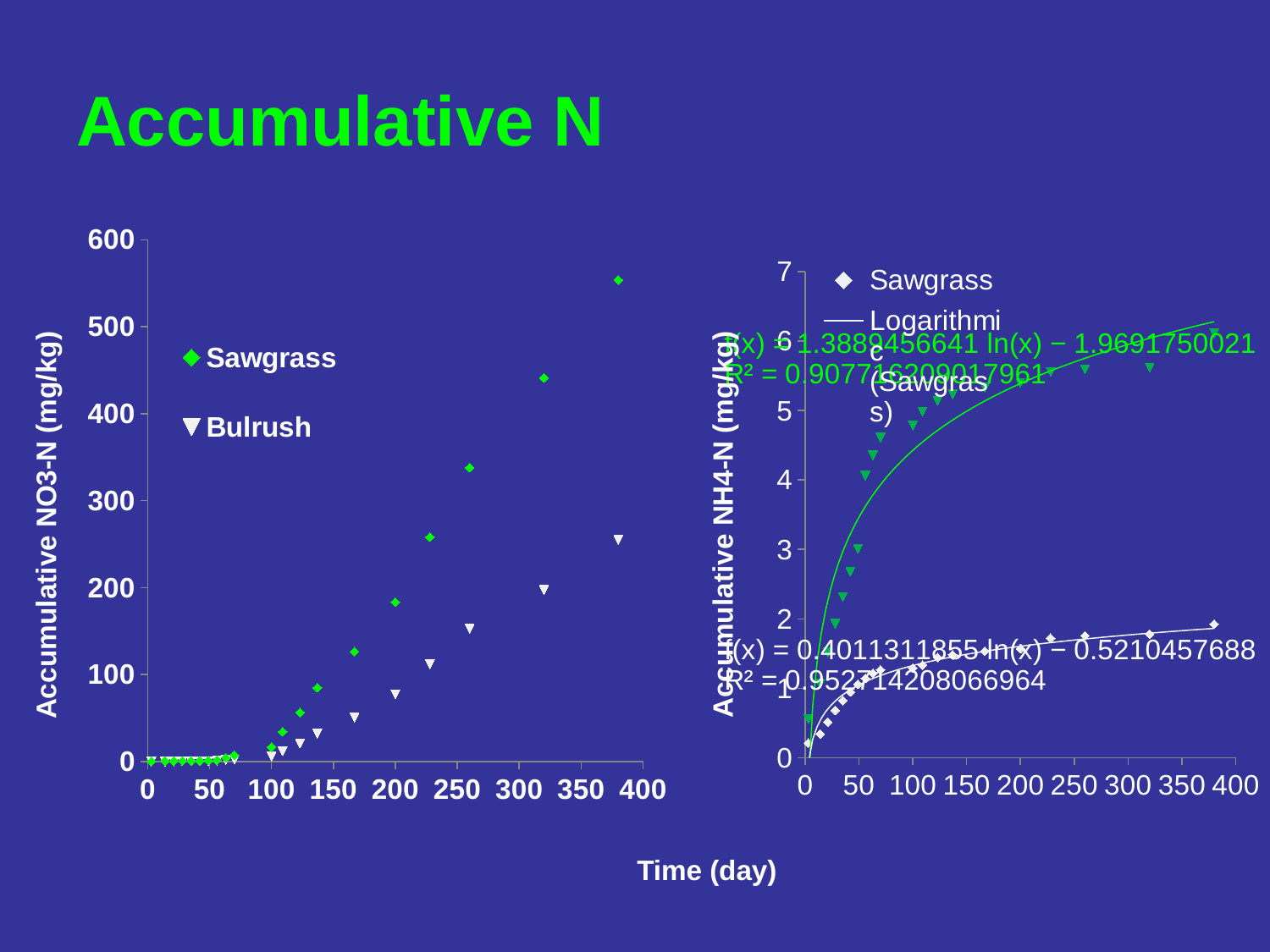
In the left chart (Accumulative NO3-N), how many series does the legend list? 2 What kind of chart is the left chart, titled with the y-axis 'Accumulative NO3-N (mg/kg)'? Scatter chart In the right chart (Accumulative NH4-N), is the green triangle series value at the last time point (around 380 days) greater or less than 5? greater In the left chart (Accumulative NO3-N), is the Bulrush value at the last time point (around 380 days) greater or less than 300? less In the left chart (Accumulative NO3-N), do the Sawgrass values rise or fall as time increases? Rise In the left chart (Accumulative NO3-N), which series has the higher value at the last time point, Sawgrass or Bulrush? Sawgrass What is the x-axis title shared by the charts on the slide? Time (day) In the left chart (Accumulative NO3-N), is the Bulrush value at around 260 days greater or less than 100? greater In the right chart (Accumulative NH4-N), what R² value is printed for the white Sawgrass logarithmic trendline? 0.952714208066964 In the right chart (Accumulative NH4-N), which series has higher values at the last time point, the green triangle series or the white Sawgrass series? Green triangle series